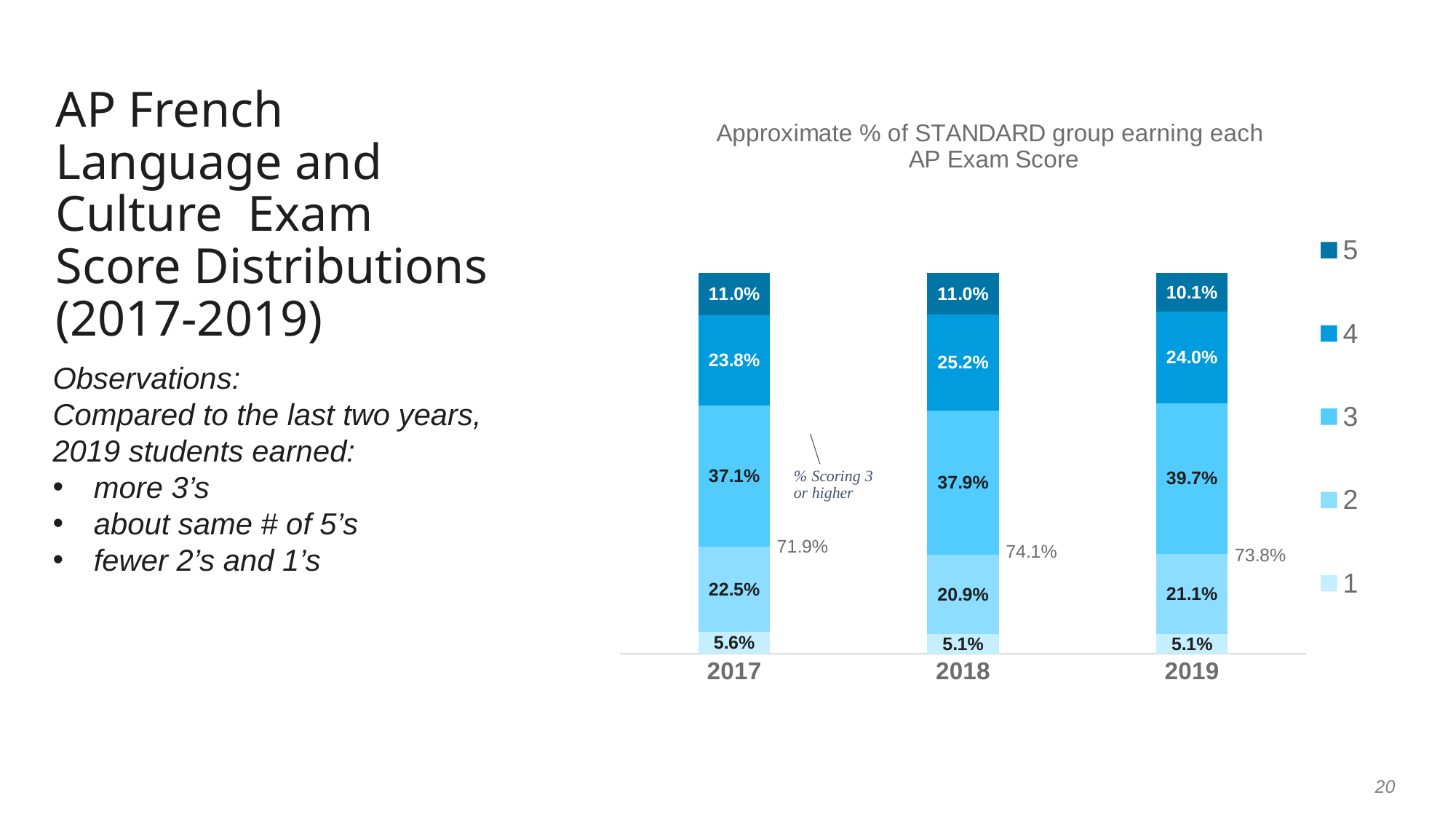
In which year was the share of students earning a score of 3 the highest? 2019 What percentage of the standard group earned a score of 3 in 2019? 39.7% Which year had a larger share of students earning a score of 4, 2018 or 2019? 2018 What kind of chart is shown on the slide? Stacked bar chart In which year was the share of students earning a score of 5 the lowest? 2019 How many years are shown on the x axis of the chart? 3 What percentage of the standard group earned a score of 1 in 2017? 5.6% What percentage of the standard group scored 3 or higher in 2018, according to the annotation on the chart? 74.1% How many series does the chart legend list? 5 Does the share of students earning a score of 3 rise or fall from 2017 to 2019? Rise What percentage of the standard group earned a score of 4 in 2018? 25.2% By how many percentage points did the share earning a score of 3 increase from 2017 to 2019? 2.6 percentage points